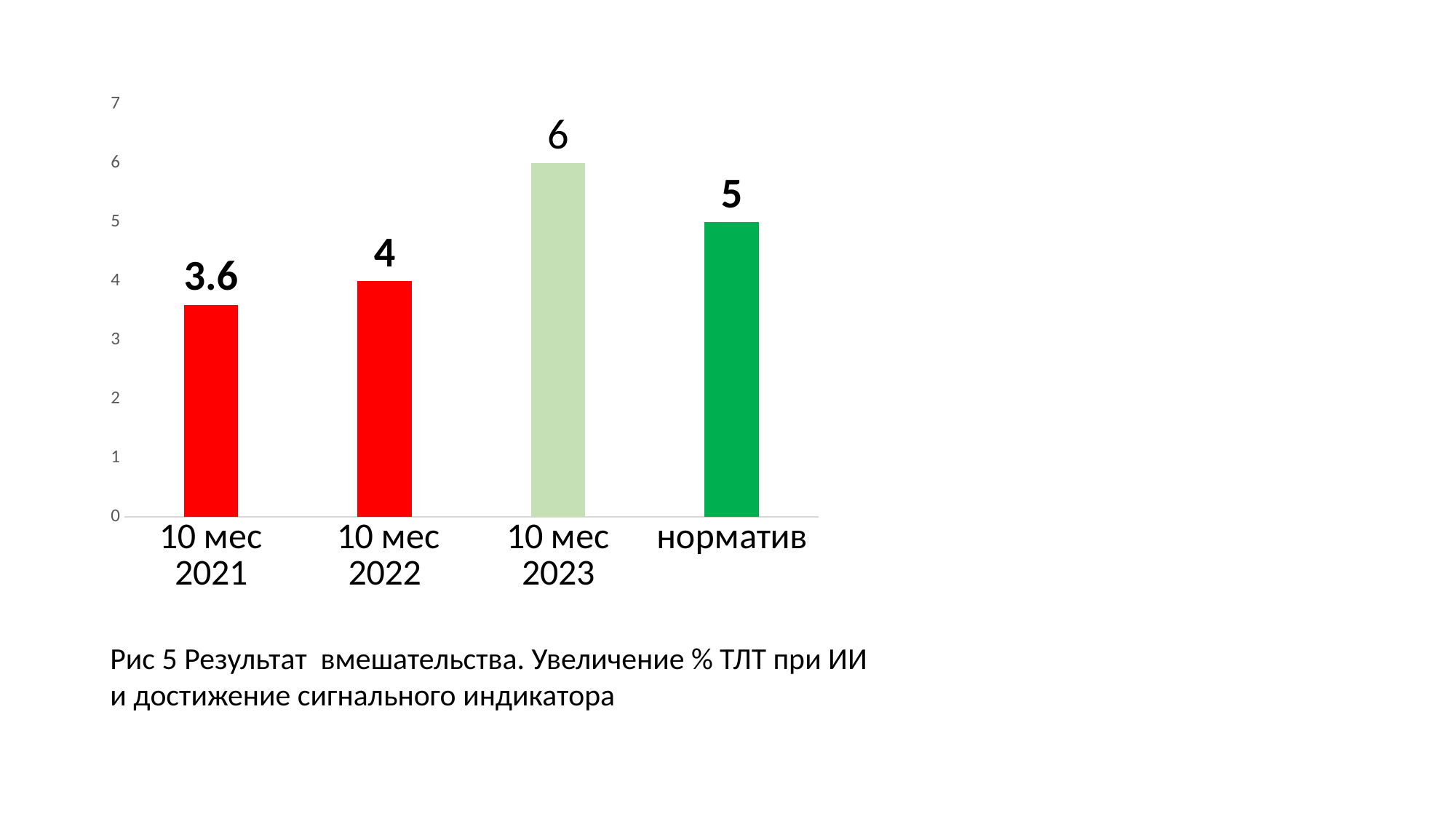
What is the difference between the values for 10 мес 2023 and 10 мес 2022? 2 What is the value for 10 мес 2021? 3.6 What is the difference between the values for 10 мес 2022 and 10 мес 2021? 0.4 Which is larger, the value for 10 мес 2023 or the value for норматив? 10 мес 2023 Which category has the highest value? 10 мес 2023 How many categories are shown on the x axis? 4 Which category has the lowest value? 10 мес 2021 Do the values rise or fall from 10 мес 2021 to 10 мес 2023? rise What kind of chart is shown on the slide? bar chart What is the value for норматив? 5 Is the value for 10 мес 2021 greater or less than 4? less What is the value for 10 мес 2023? 6